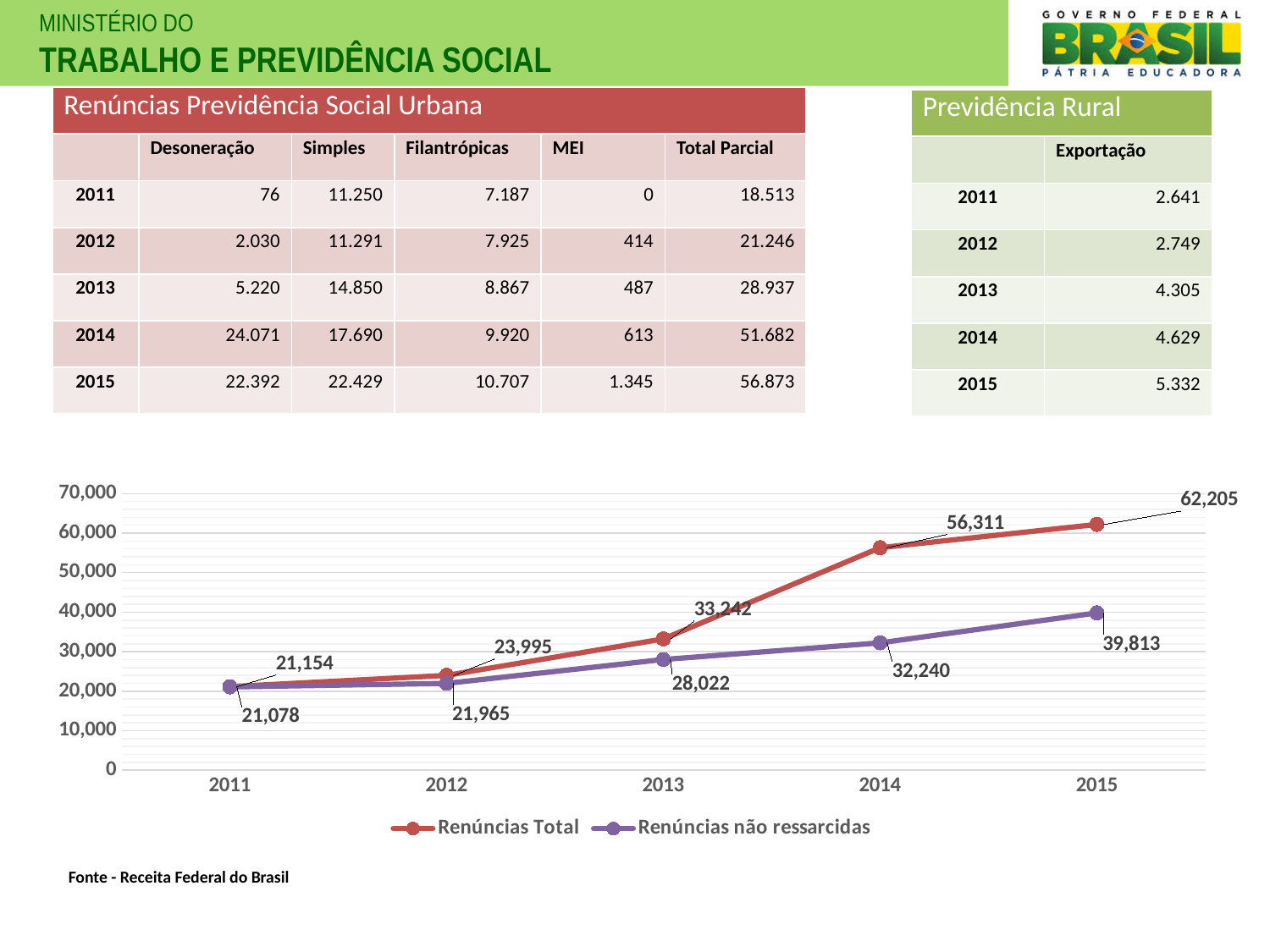
Which colour is used for the Renúncias Total line? red How many series does the chart legend list? 2 Which is larger in 2012: Renúncias Total or Renúncias não ressarcidas? Renúncias Total What type of chart is shown at the bottom of the slide? line chart In which year is Renúncias Total lowest? 2011 What is the difference between Renúncias Total and Renúncias não ressarcidas in 2014? 24,071 Does Renúncias Total rise or fall from 2011 to 2015? rise What is the value of Renúncias Total in 2011? 21,154 How many years are plotted on the x axis of the chart? 5 What is the value of Renúncias não ressarcidas in 2013? 28,022 In which year is Renúncias não ressarcidas highest? 2015 What is the value of Renúncias Total in 2015? 62,205